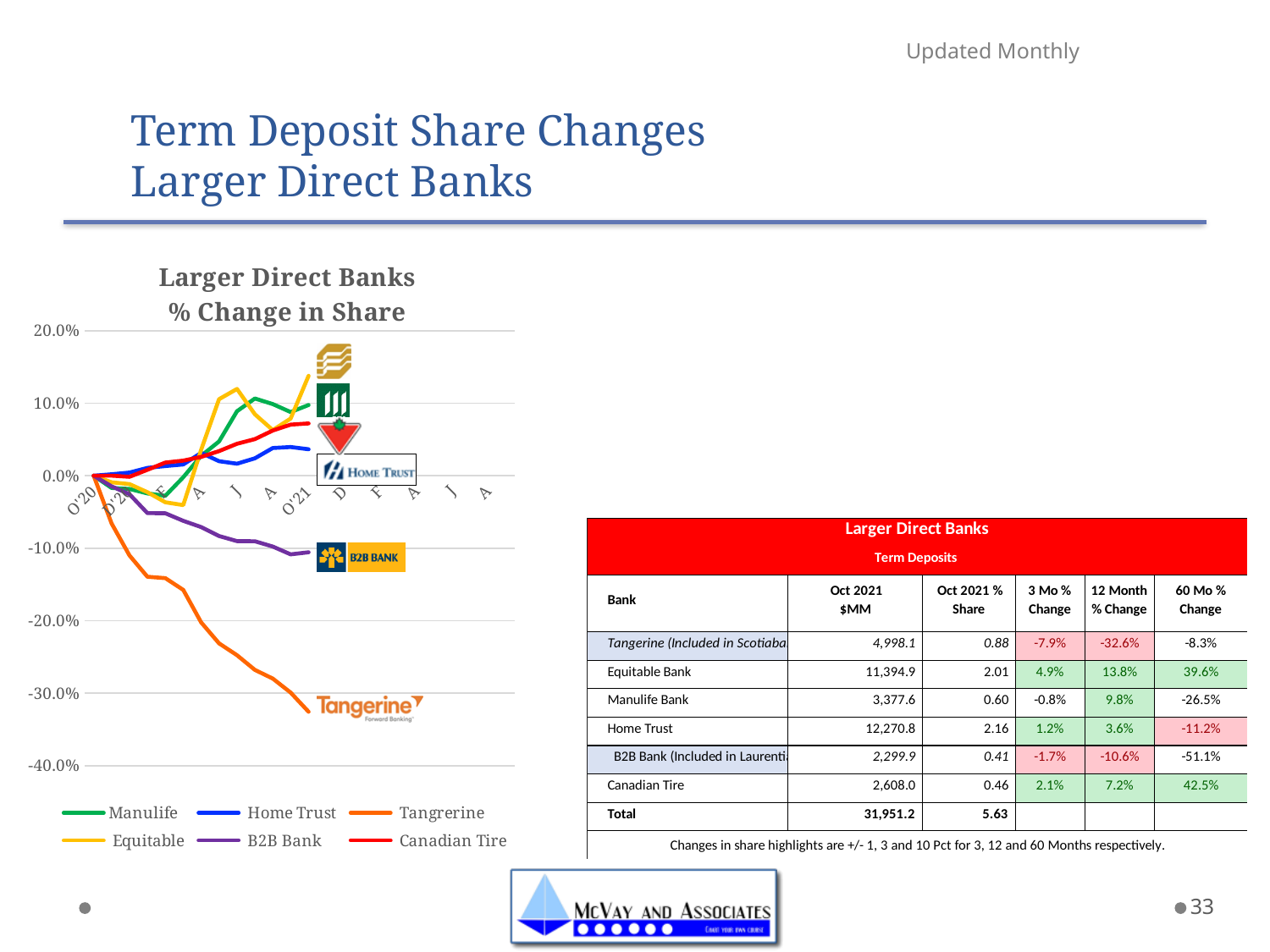
How many series does the chart legend list? 6 Which series has the highest value at the end of the chart? Equitable What kind of chart is shown on the slide? line chart Which series has the lowest value at the end of the chart? Tangerine Does the Tangerine line rise or fall along the x axis? fall What colour is the Manulife line in the chart? green Is the final value for Canadian Tire greater or less than 0.0%? greater Is the final value for Tangerine greater or less than -30.0%? less Does the Canadian Tire line rise or fall along the x axis? rise At the end of the chart, which is larger: the value for B2B Bank or the value for Home Trust? Home Trust Is the final value for Home Trust greater or less than 10.0%? less